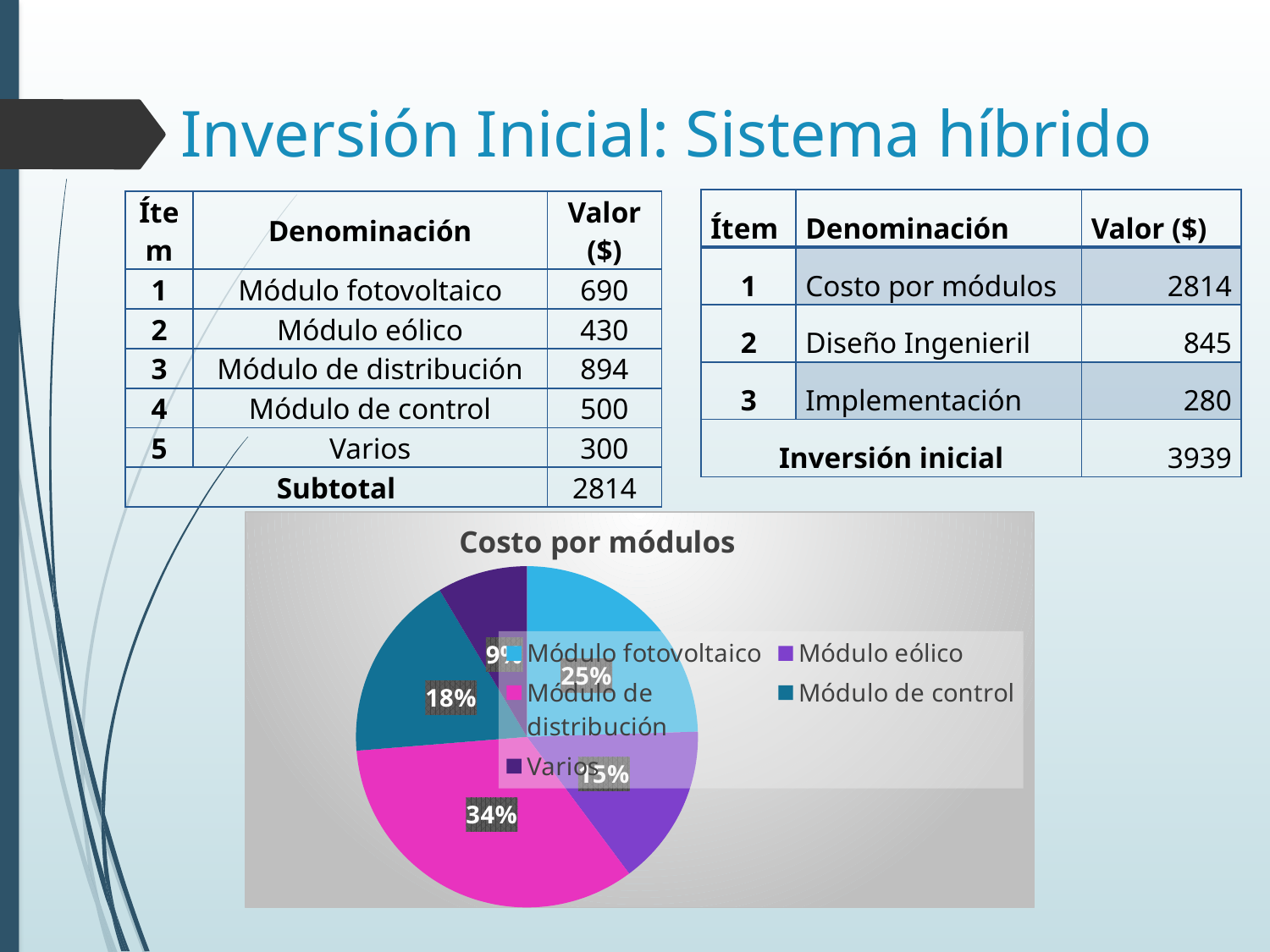
What percentage of the pie chart does Módulo fotovoltaico represent? 25% How many entries does the pie chart's legend list? 5 What percentage of the pie chart does Módulo de distribución represent? 34% How many slices does the pie chart have? 5 By how many percentage points does the Módulo de distribución slice exceed the Módulo de control slice? 16 percentage points Which slice is larger in the pie chart, Módulo fotovoltaico or Módulo de control? Módulo fotovoltaico What is the title of the pie chart? Costo por módulos Which category has the smallest slice in the pie chart? Varios Which slice is larger in the pie chart, Módulo de distribución or Módulo fotovoltaico? Módulo de distribución Which category has the largest slice in the pie chart? Módulo de distribución What percentage of the pie chart does Módulo de control represent? 18% What kind of chart is shown on the slide? Pie chart